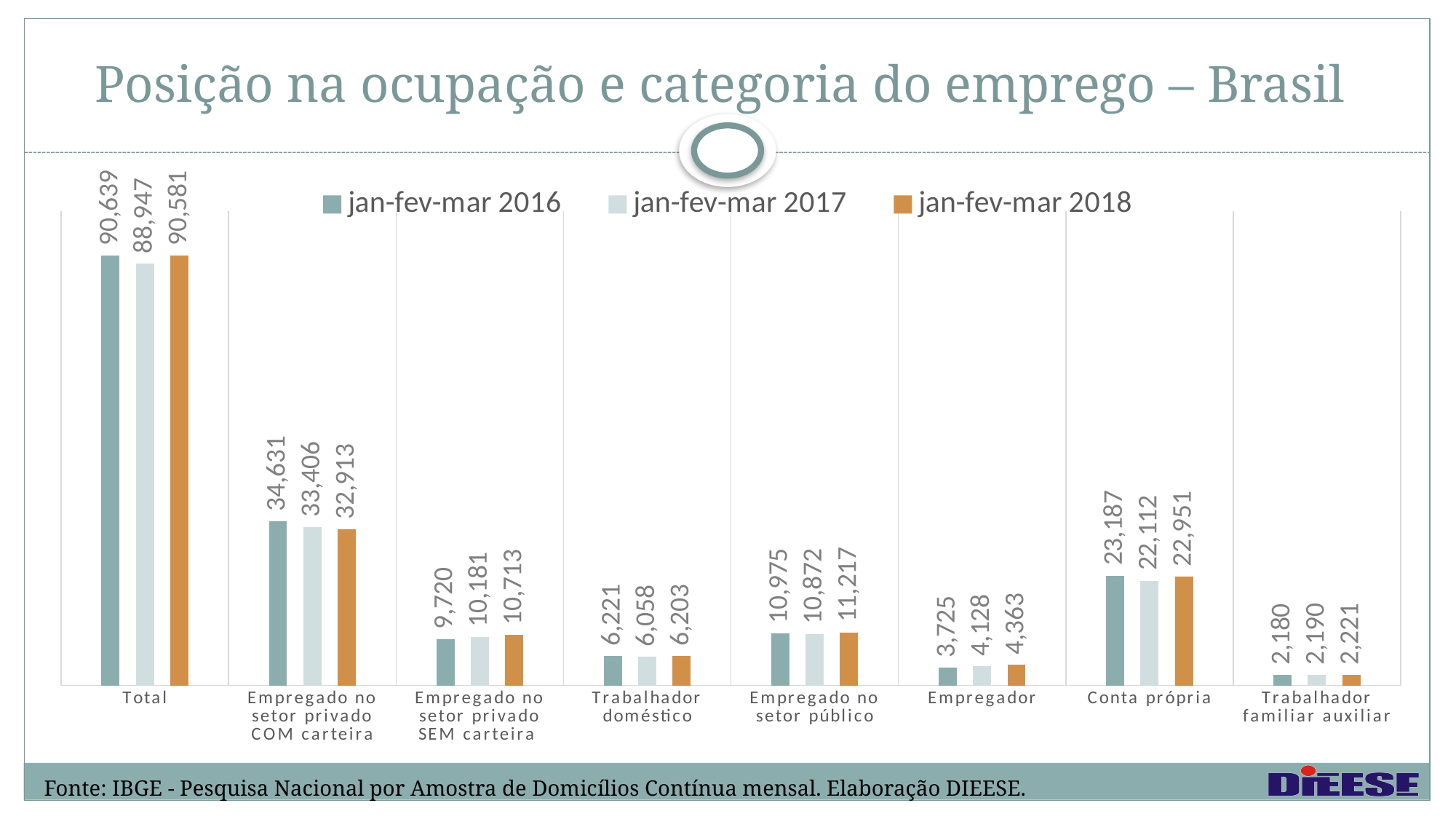
How many categories are shown on the x axis? 8 What is the difference between the jan-fev-mar 2016 and jan-fev-mar 2018 values for Empregado no setor privado COM carteira? 1,718 Do the values for Empregado no setor privado SEM carteira rise or fall from jan-fev-mar 2016 to jan-fev-mar 2018? Rise Excluding Total, which category has the highest value in jan-fev-mar 2016? Empregado no setor privado COM carteira What is the value for Empregador in jan-fev-mar 2017? 4,128 What is the title of the chart? Posição na ocupação e categoria do emprego – Brasil Which category has the lowest value in jan-fev-mar 2018? Trabalhador familiar auxiliar What kind of chart is shown on the slide? Bar chart How many series does the legend list? 3 What is the value for Total in jan-fev-mar 2016? 90,639 What is the value for Conta própria in jan-fev-mar 2018? 22,951 Which is larger for Empregado no setor público: jan-fev-mar 2017 or jan-fev-mar 2018? jan-fev-mar 2018